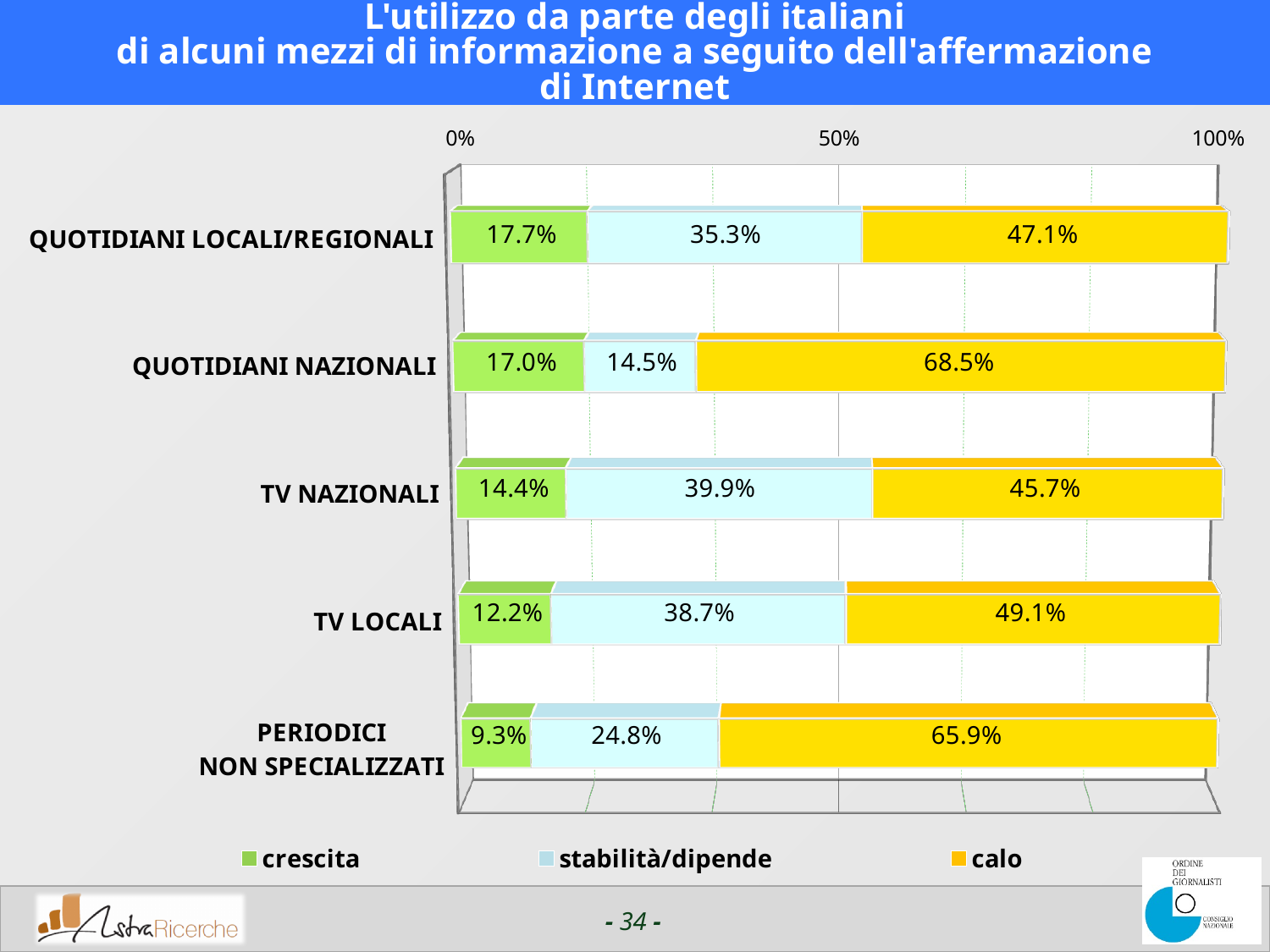
Which category has the highest 'calo' value? QUOTIDIANI NAZIONALI What kind of chart is shown on the slide? Stacked bar chart What is the difference in percentage points between the 'calo' values for QUOTIDIANI NAZIONALI and TV NAZIONALI? 22.8 What is the 'crescita' value for PERIODICI NON SPECIALIZZATI? 9.3% How many series does the legend list? 3 Which is larger: the 'stabilità/dipende' value for QUOTIDIANI LOCALI/REGIONALI or for QUOTIDIANI NAZIONALI? QUOTIDIANI LOCALI/REGIONALI What is the total of the stacked bar for TV NAZIONALI? 100.0% What is the 'stabilità/dipende' value for TV LOCALI? 38.7% What is the 'calo' value for QUOTIDIANI NAZIONALI? 68.5% How many categories are shown on the chart? 5 Which category has the lowest 'crescita' value? PERIODICI NON SPECIALIZZATI Which legend entry is shown in yellow? calo